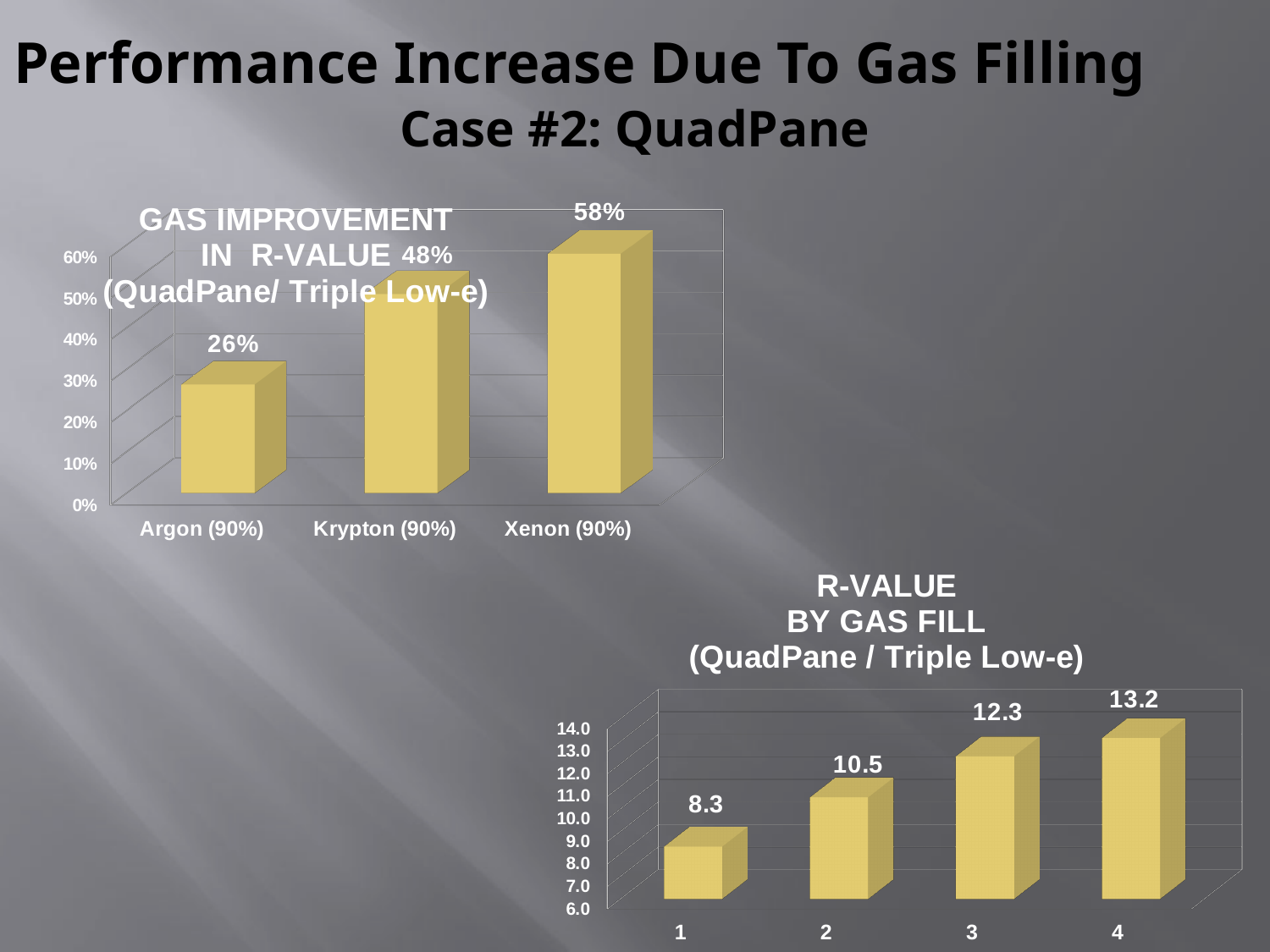
In the R-VALUE BY GAS FILL chart, what is the difference between the values for category 3 and category 1? 4.0 What kind of chart is the R-VALUE BY GAS FILL chart? bar chart In the R-VALUE BY GAS FILL chart, what is the value for category 4? 13.2 In the GAS IMPROVEMENT IN R-VALUE chart, do the values rise or fall from Argon to Xenon? rise In the R-VALUE BY GAS FILL chart, is the value for category 2 larger or smaller than the value for category 3? smaller In the GAS IMPROVEMENT IN R-VALUE chart, which gas has the highest improvement? Xenon (90%) In the GAS IMPROVEMENT IN R-VALUE chart, which gas has the lowest improvement? Argon (90%) In the R-VALUE BY GAS FILL chart, what is the value for category 2? 10.5 In the GAS IMPROVEMENT IN R-VALUE chart, how many gas categories are shown? 3 In the GAS IMPROVEMENT IN R-VALUE chart, what is the value for Krypton (90%)? 48% In the R-VALUE BY GAS FILL chart, which category has the lowest R-value? 1 In the GAS IMPROVEMENT IN R-VALUE chart, what is the difference between the values for Xenon (90%) and Argon (90%)? 32%